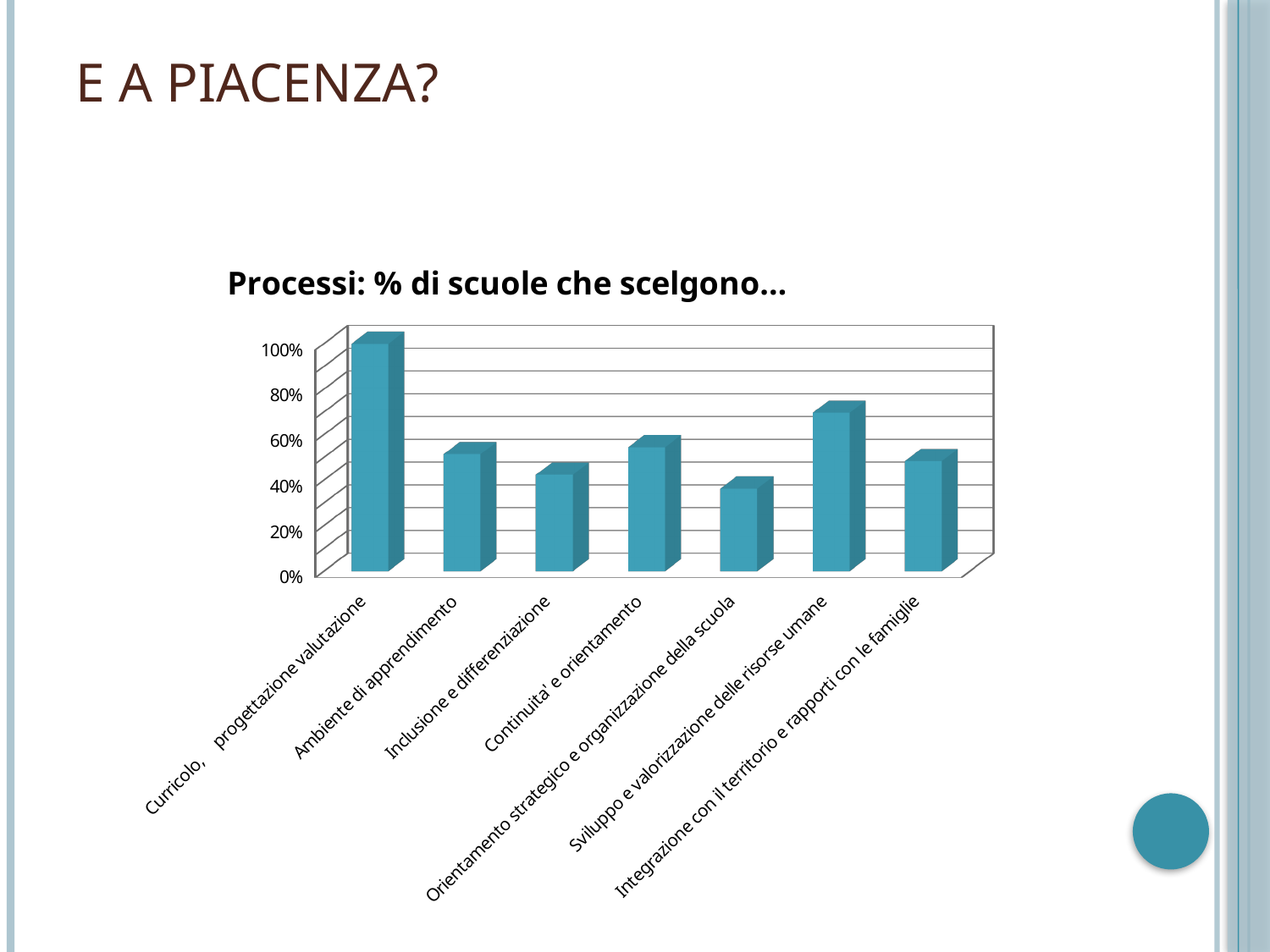
What is the title of the chart? Processi: % di scuole che scelgono... Is the value for Inclusione e differenziazione greater or less than 60%? less Which is larger: the value for Curricolo, progettazione valutazione or the value for Continuita' e orientamento? Curricolo, progettazione valutazione How many categories are shown on the x axis of the chart? 7 Is the value for Integrazione con il territorio e rapporti con le famiglie greater or less than 60%? less Which category has the highest value in the chart? Curricolo, progettazione valutazione Which is larger: the value for Sviluppo e valorizzazione delle risorse umane or the value for Ambiente di apprendimento? Sviluppo e valorizzazione delle risorse umane Is the value for Sviluppo e valorizzazione delle risorse umane greater or less than 60%? greater What kind of chart is shown on the slide? bar chart